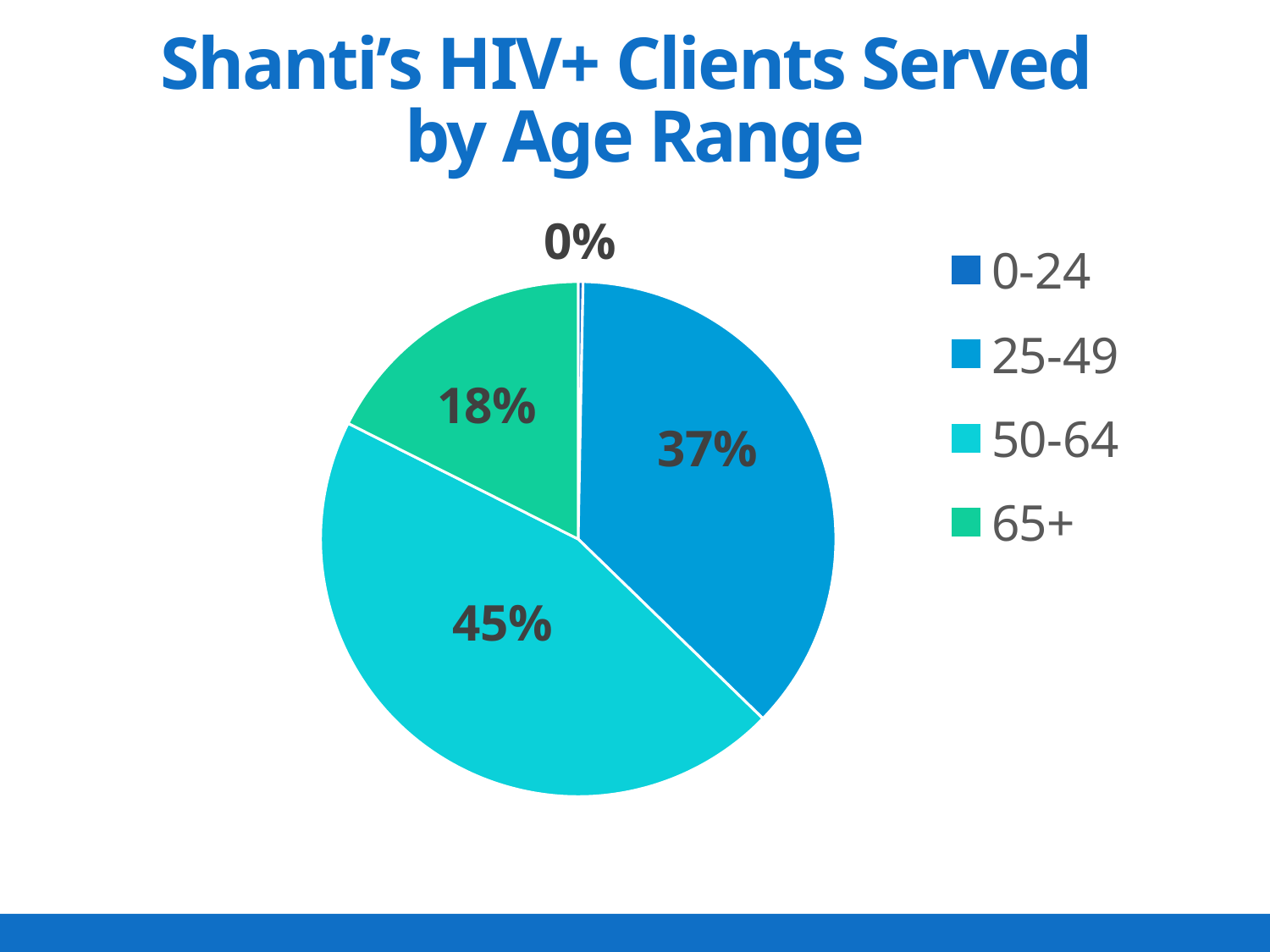
Which age range has the smallest share of HIV+ clients served? 0-24 What is the difference in percentage points between the 50-64 and 25-49 age ranges? 8 What kind of chart is shown on the slide? Pie chart Which age range has the largest share of HIV+ clients served? 50-64 What share of Shanti's HIV+ clients served are in the 25-49 age range? 37% How many age ranges does the legend list? 4 What share of Shanti's HIV+ clients served are in the 50-64 age range? 45% Which age range has a larger share: 25-49 or 65+? 25-49 What share of Shanti's HIV+ clients served are in the 65+ age range? 18% What is the title of the chart? Shanti's HIV+ Clients Served by Age Range What share of Shanti's HIV+ clients served are in the 0-24 age range? 0% What is the difference in percentage points between the 25-49 and 65+ age ranges? 19